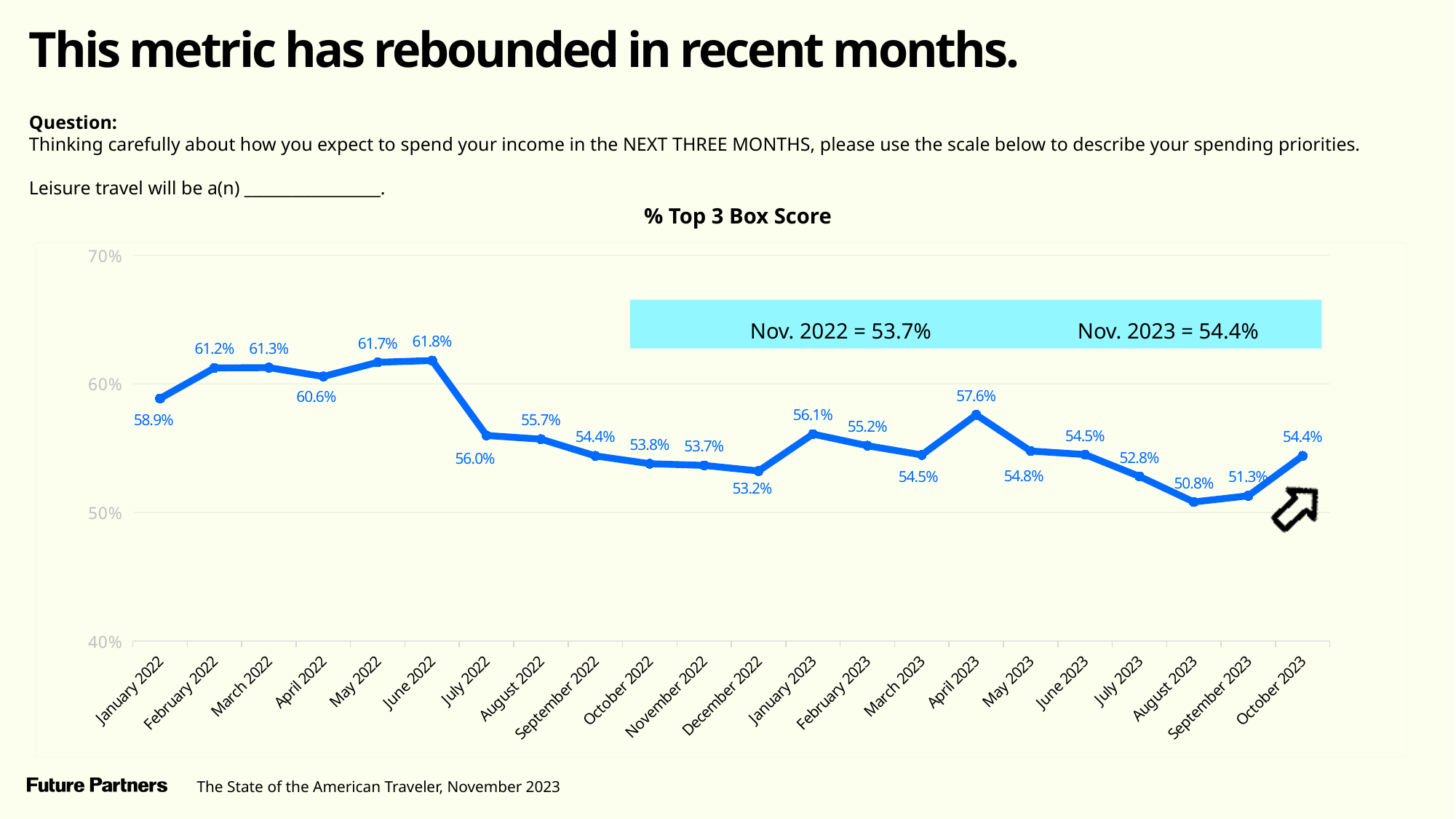
What is the % Top 3 Box Score for June 2022? 61.8% Which month has the lowest % Top 3 Box Score? August 2023 What kind of chart is shown on the slide? Line chart What is the % Top 3 Box Score for August 2023? 50.8% What is the difference between the % Top 3 Box Score for April 2023 and March 2023? 3.1% What is the % Top 3 Box Score for October 2023? 54.4% Is the value for July 2023 greater or less than 50%? greater Which is larger, the % Top 3 Box Score for January 2023 or December 2022? January 2023 Which month has the highest % Top 3 Box Score? June 2022 Does the % Top 3 Box Score rise or fall from August 2023 to October 2023? Rise How many months are plotted on the chart? 22 What is the difference between the % Top 3 Box Score for October 2023 and August 2023? 3.6%